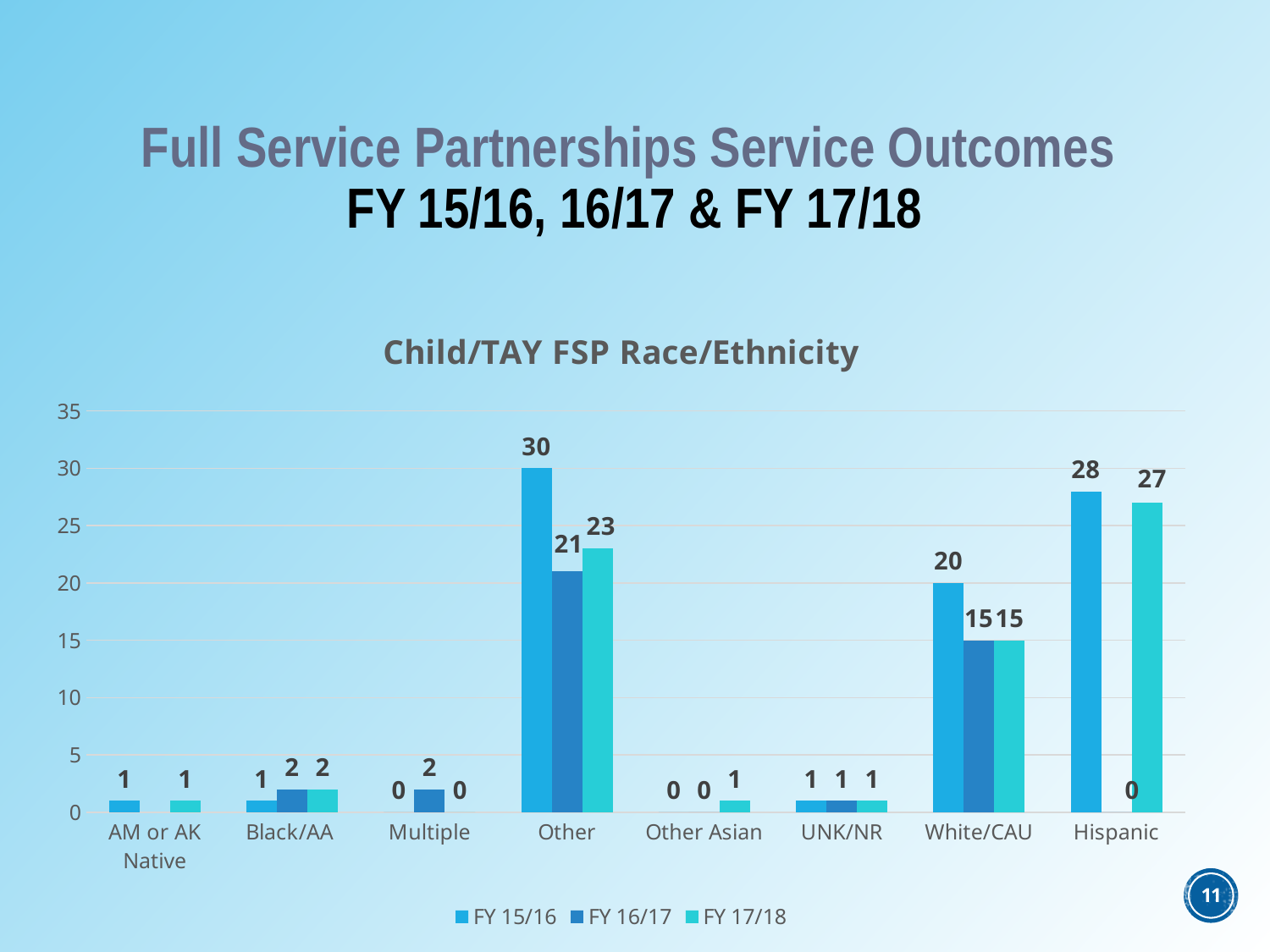
What is the difference between the FY 15/16 and FY 16/17 values for Other? 9 How many series does the legend list? 3 What is the FY 16/17 value for White/CAU? 15 What is the FY 15/16 value for Other in the Child/TAY FSP Race/Ethnicity chart? 30 What kind of chart is shown on the slide? Bar chart What is the difference between the FY 15/16 and FY 17/18 values for White/CAU? 5 Which category has the highest FY 15/16 value? Other Which is larger: the FY 15/16 value for Hispanic or the FY 15/16 value for White/CAU? Hispanic Which category has the highest FY 17/18 value? Hispanic What is the title of the chart? Child/TAY FSP Race/Ethnicity What is the FY 17/18 value for Hispanic? 27 How many race/ethnicity categories are shown on the x axis? 8